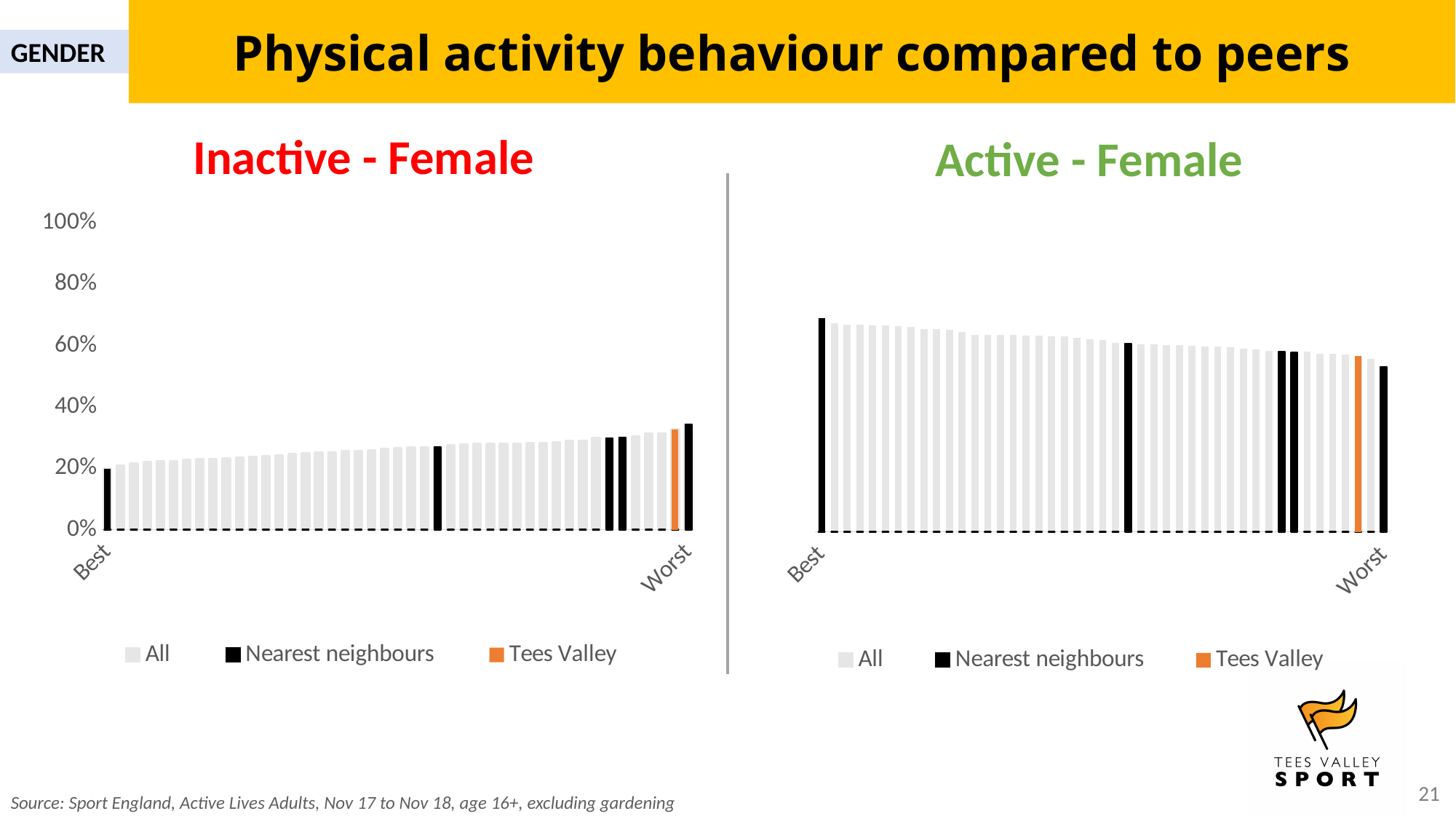
In the Active - Female chart, is the Tees Valley bar higher or lower than the Best bar? lower In the Inactive - Female chart, is the Tees Valley bar higher or lower than the Best bar? higher In the Inactive - Female chart, is the value for Tees Valley greater or less than 40%? less What are the three legend entries of the Inactive - Female chart? All, Nearest neighbours, Tees Valley In the Active - Female chart, do the values rise or fall from Best to Worst along the x axis? fall In the Inactive - Female chart, which series is shown in orange? Tees Valley How many series does the legend of the Active - Female chart list? 3 What kind of chart is the Inactive - Female chart? bar chart In the Inactive - Female chart, is the value of the Worst bar greater or less than 40%? less In the Inactive - Female chart, is the value for Tees Valley greater or less than 20%? greater In the Inactive - Female chart, do the values rise or fall from Best to Worst along the x axis? rise